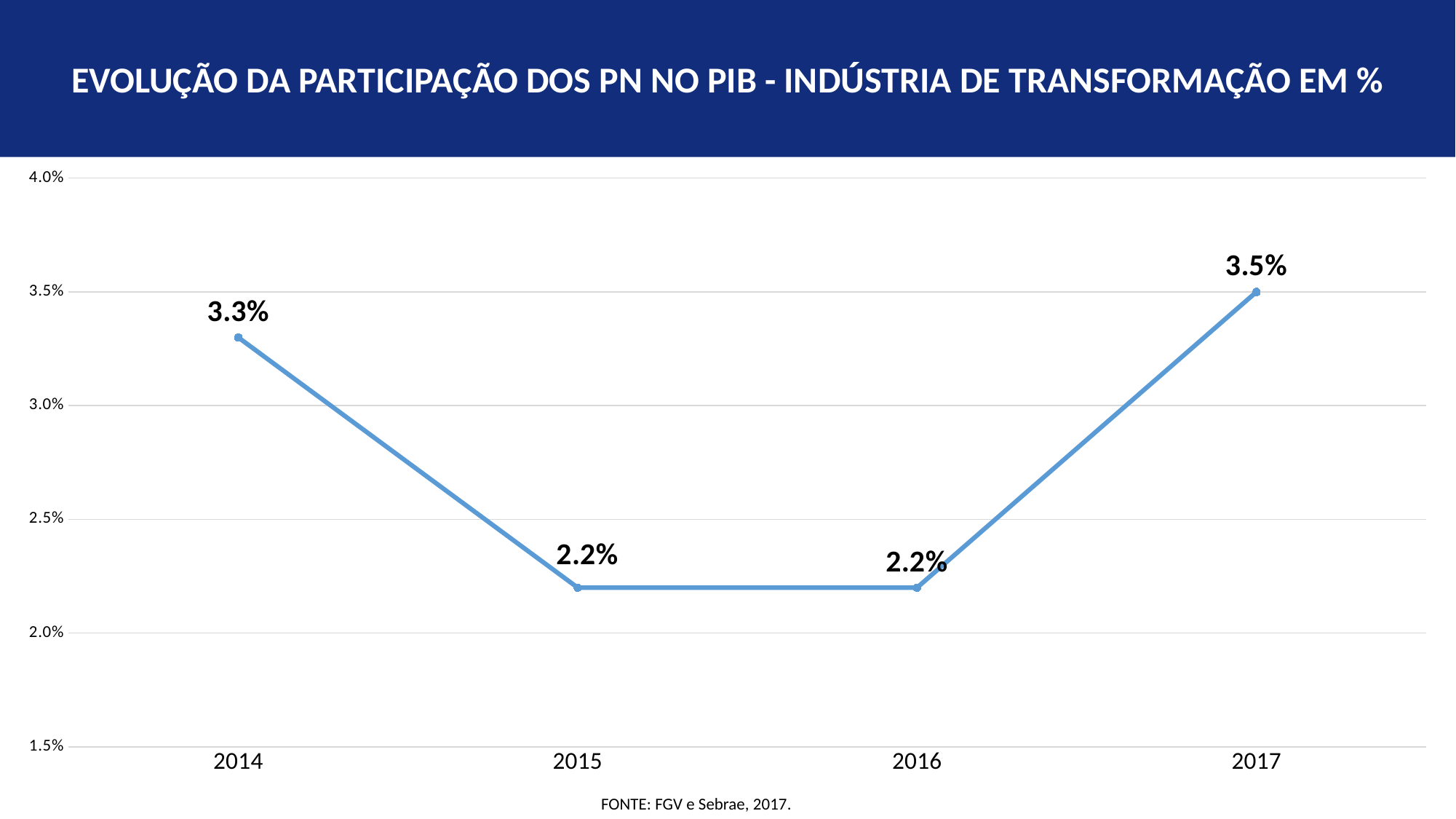
What is the source cited below the chart? FGV e Sebrae, 2017. Does the value rise or fall from 2016 to 2017? rise How many years are plotted on the chart? 4 What is the difference between the values for 2017 and 2014? 0.2% What is the value for 2015? 2.2% Which year has the highest value? 2017 What kind of chart is shown on the slide? line chart Which is larger, the value for 2014 or the value for 2017? 2017 What is the difference between the values for 2014 and 2015? 1.1% What is the value for 2014? 3.3% What is the value for 2017? 3.5% Is the value for 2016 greater or less than 2.5%? less